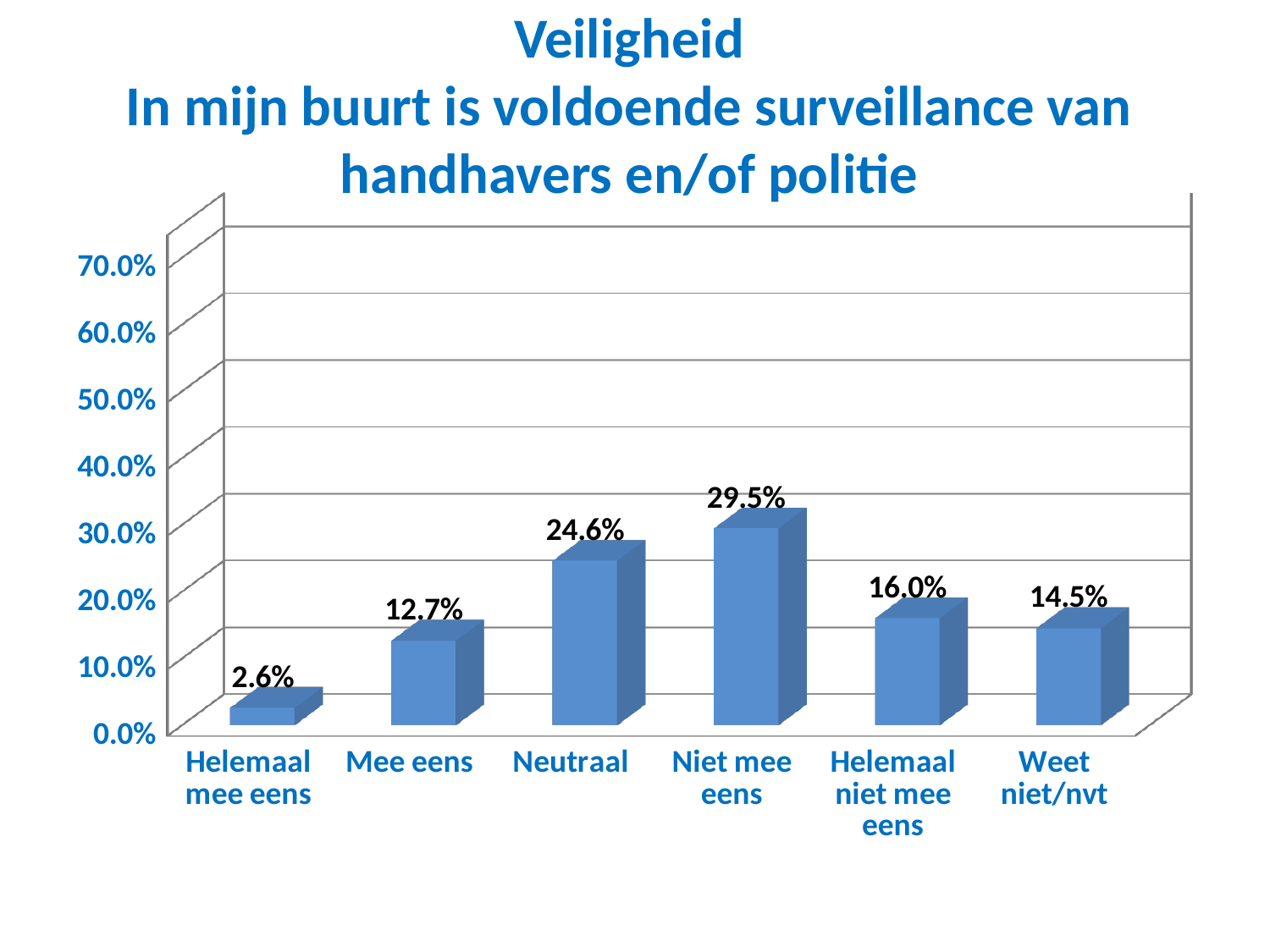
Which is larger, the value for Mee eens or the value for Helemaal niet mee eens? Helemaal niet mee eens Is the value for Neutraal greater or less than 20.0%? greater What is the value for Helemaal mee eens? 2.6% Which category has the highest value? Niet mee eens What is the difference between the values for Helemaal niet mee eens and Weet niet/nvt? 1.5% What is the value for Neutraal? 24.6% What kind of chart is shown on the slide? bar chart What is the value for Weet niet/nvt? 14.5% What is the title of the chart? Veiligheid In mijn buurt is voldoende surveillance van handhavers en/of politie Which category has the lowest value? Helemaal mee eens How many categories are shown on the x axis? 6 What is the difference between the values for Niet mee eens and Neutraal? 4.9%